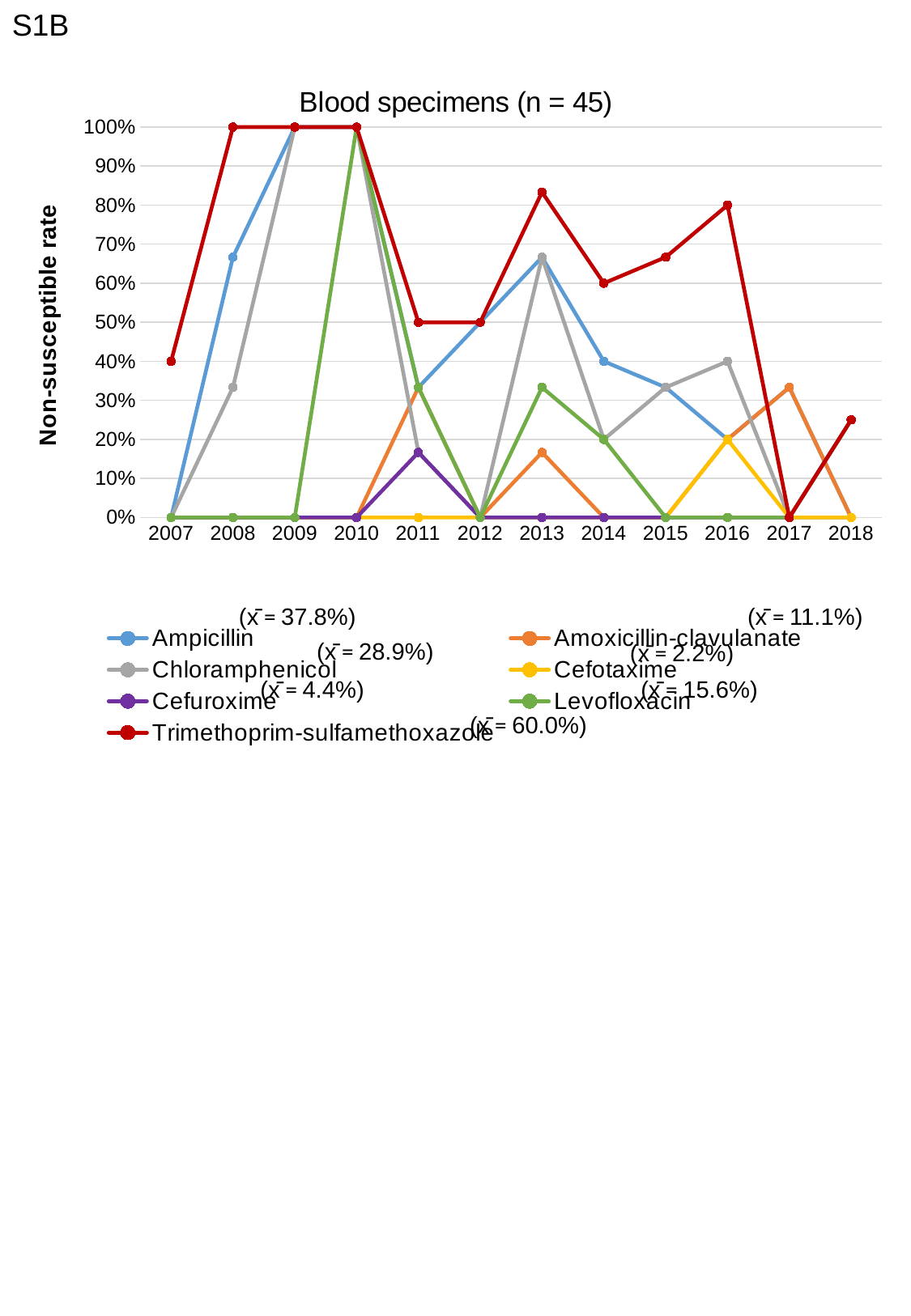
What is the non-susceptible rate for Trimethoprim-sulfamethoxazole in 2007? 40% What is the non-susceptible rate for Ampicillin in 2014? 40% Is the value for Trimethoprim-sulfamethoxazole in 2013 greater or less than 80%? greater What is the non-susceptible rate for Trimethoprim-sulfamethoxazole in 2016? 80% What is the title of the chart? Blood specimens (n = 45) How many series does the legend list? 7 What is the non-susceptible rate for Levofloxacin in 2010? 100% Which series has the highest mean non-susceptible rate according to the legend? Trimethoprim-sulfamethoxazole Which series has the lowest mean non-susceptible rate according to the legend? Cefotaxime What kind of chart is shown on the slide? Line chart In 2013, which is larger: the value for Trimethoprim-sulfamethoxazole or the value for Ampicillin? Trimethoprim-sulfamethoxazole How many years are shown along the x axis? 12